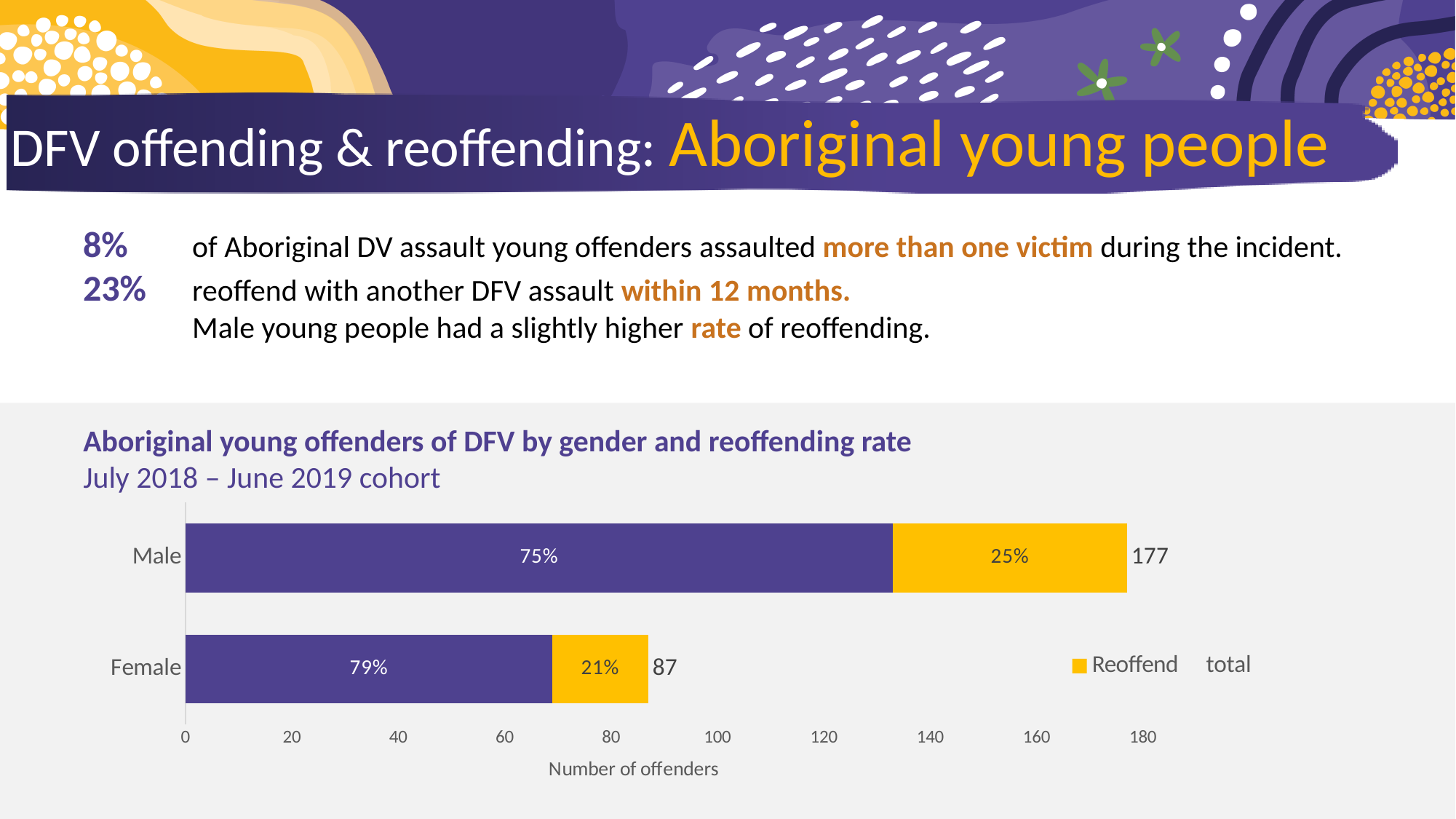
Is the purple (non-reoffend) portion of the Male bar greater or less than 120 offenders? greater What kind of chart is shown on the slide? Stacked bar chart Which gender has the higher total number of offenders? Male How many gender categories are plotted in the chart? 2 What is the label of the horizontal axis of the chart? Number of offenders What total number of offenders is printed at the end of the Male bar? 177 What total number of offenders is printed at the end of the Female bar? 87 What percentage label is shown on the purple segment of the Female bar? 79% What percentage label is shown on the yellow Reoffend segment for Female? 21% What is the difference between the Male total (177) and the Female total (87)? 90 What percentage label is shown on the yellow Reoffend segment for Male? 25% Is the Reoffend percentage for Male larger or smaller than for Female? larger